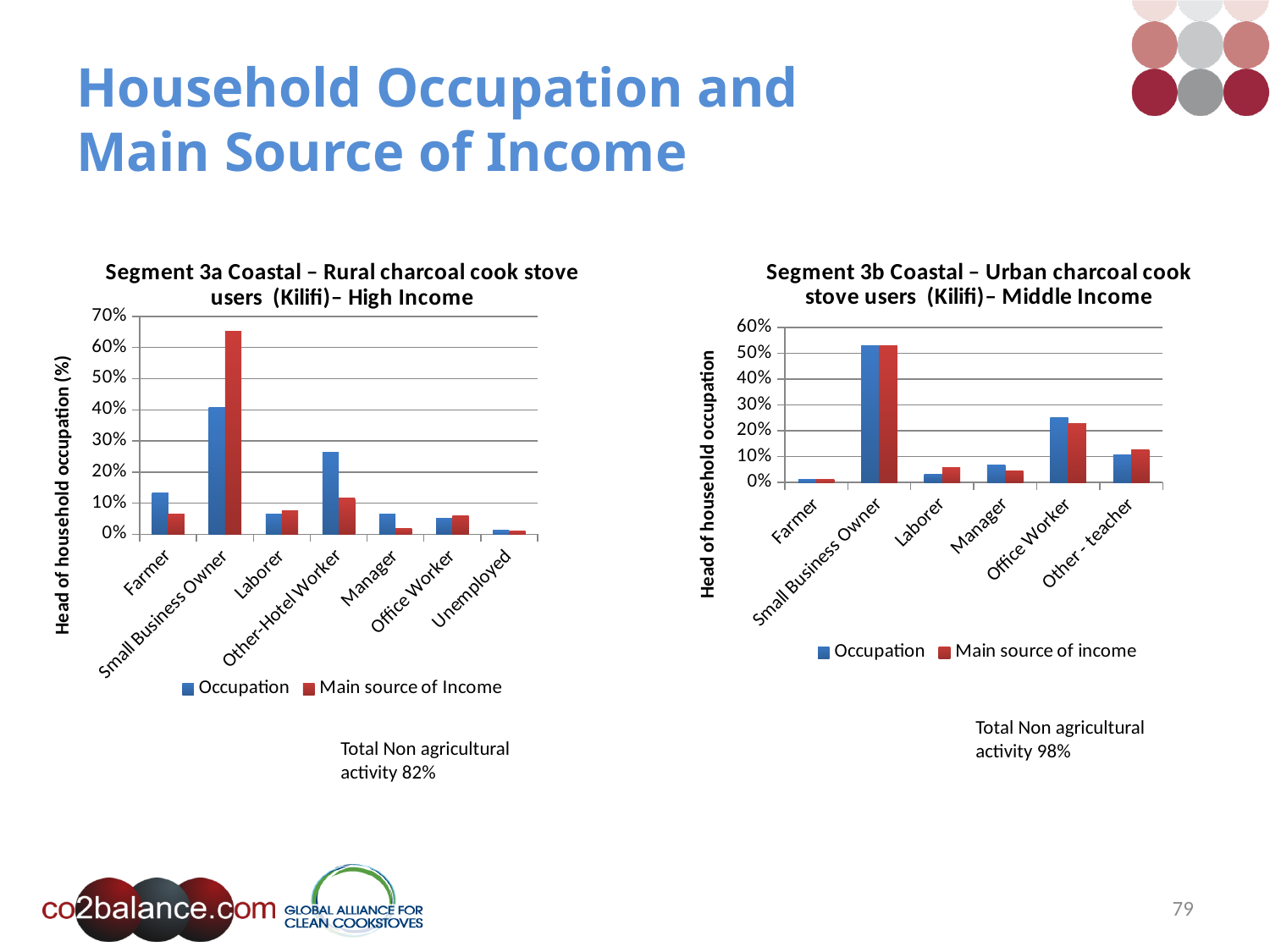
How many series does the legend of the Segment 3b Coastal – Urban chart on the right list? 2 In the Segment 3b Coastal – Urban chart on the right, which is larger for Laborer: the Occupation value or the Main source of income value? Main source of income In the Segment 3a Coastal – Rural chart on the left, which is larger for Farmer: the Occupation value or the Main source of Income value? Occupation In the Segment 3b Coastal – Urban chart on the right, is the Occupation value for Office Worker greater or less than 30%? less In the Segment 3b Coastal – Urban chart on the right, which category has the highest Occupation value? Small Business Owner In the Segment 3a Coastal – Rural chart on the left, which category has the lowest Occupation value? Unemployed In the Segment 3a Coastal – Rural chart on the left, is the Occupation value for Other-Hotel Worker greater or less than 20%? greater How many occupation categories are shown on the x axis of the Segment 3a Coastal – Rural chart on the left? 7 In the Segment 3a Coastal – Rural chart on the left, which category has the highest Main source of Income value? Small Business Owner In the Segment 3b Coastal – Urban chart on the right, is the Occupation value for Small Business Owner greater or less than 50%? greater What type of chart is the Segment 3b Coastal – Urban chart on the right? Bar chart